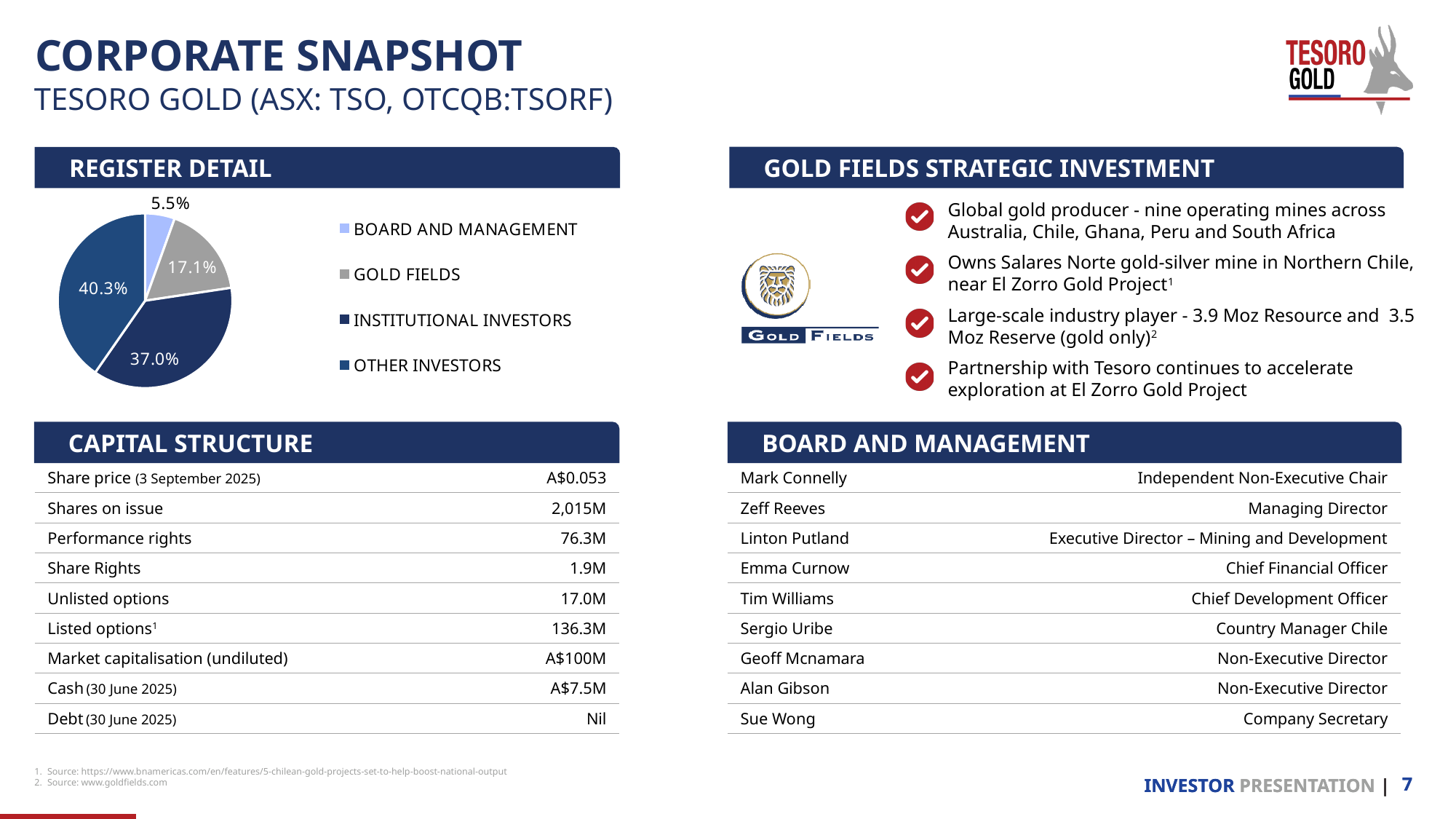
What type of chart is shown under Register Detail? Pie chart In the Register Detail pie chart, which is larger: the Gold Fields share or the Board and Management share? Gold Fields In the Register Detail pie chart, what share is held by Gold Fields? 17.1% Which category has the largest slice in the Register Detail pie chart? Other Investors In the Register Detail pie chart, which category is shown in grey? Gold Fields In the Register Detail pie chart, what is the difference between the Other Investors share and the Institutional Investors share? 3.3% In the Register Detail pie chart, what share is held by Institutional Investors? 37.0% In the Register Detail pie chart, what share is held by Other Investors? 40.3% Which category has the smallest slice in the Register Detail pie chart? Board and Management In the Register Detail pie chart, what share is held by Board and Management? 5.5% In the Register Detail pie chart, what is the combined share of Gold Fields and Institutional Investors? 54.1% How many slices does the Register Detail pie chart have? 4